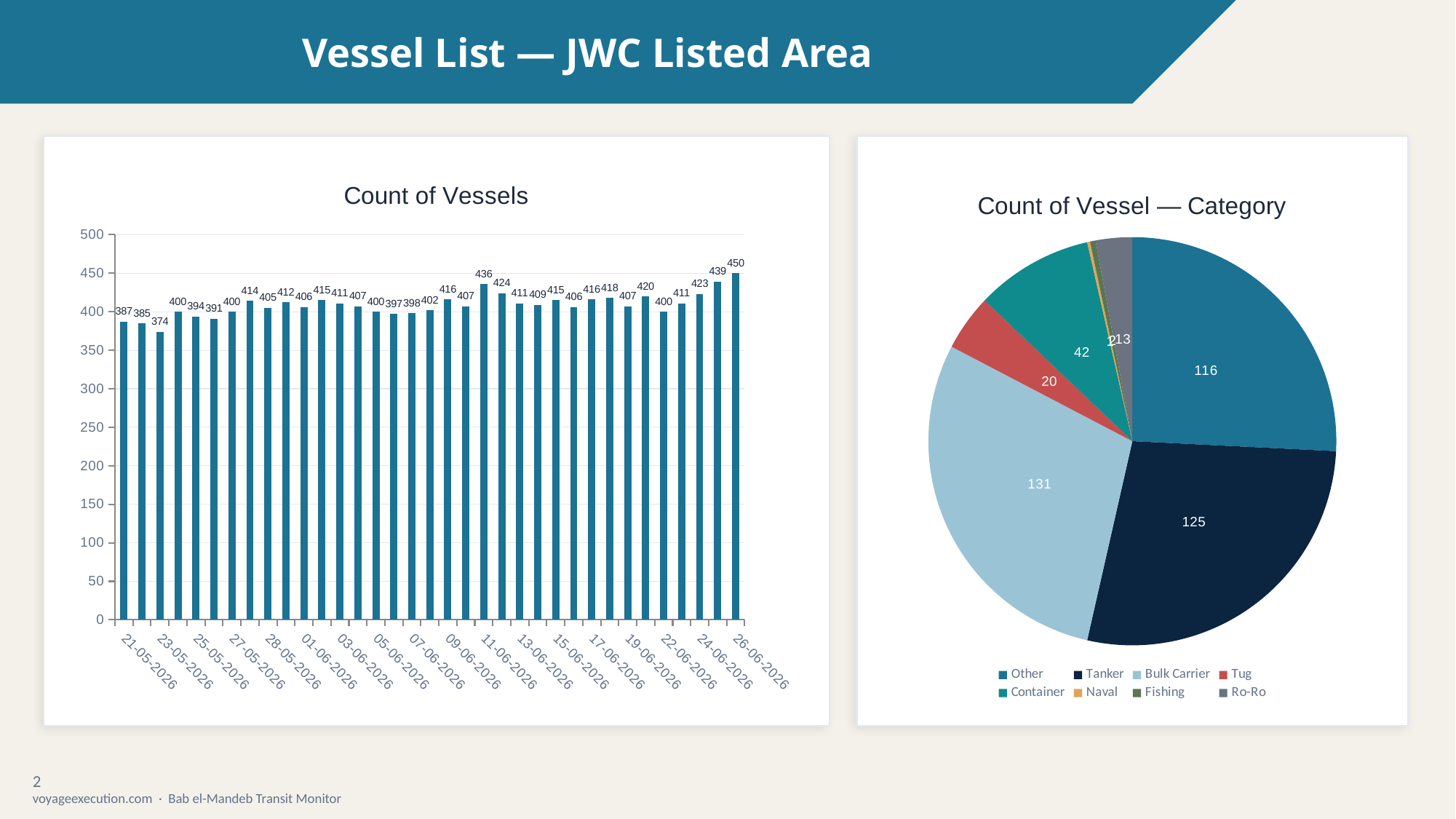
How many categories does the legend of the 'Count of Vessel — Category' pie chart list? 8 In the 'Count of Vessels' chart, what is the value for 26-06-2026? 450 What kind of chart is the 'Count of Vessel — Category' chart on the right? pie chart In the 'Count of Vessels' chart, what is the difference between the values for 26-06-2026 and 21-05-2026? 63 In the 'Count of Vessels' chart, what is the value for 21-05-2026? 387 In the 'Count of Vessel — Category' pie chart, what is the value for Bulk Carrier? 131 In the 'Count of Vessel — Category' pie chart, what is the value for Tanker? 125 In the 'Count of Vessel — Category' pie chart, which category has the largest slice? Bulk Carrier In the 'Count of Vessels' chart, which date has the lowest count? 23-05-2026 In the 'Count of Vessel — Category' pie chart, which is larger, Tanker or Other? Tanker What kind of chart is the 'Count of Vessels' chart on the left? bar chart In the 'Count of Vessels' chart, which date has the highest count? 26-06-2026